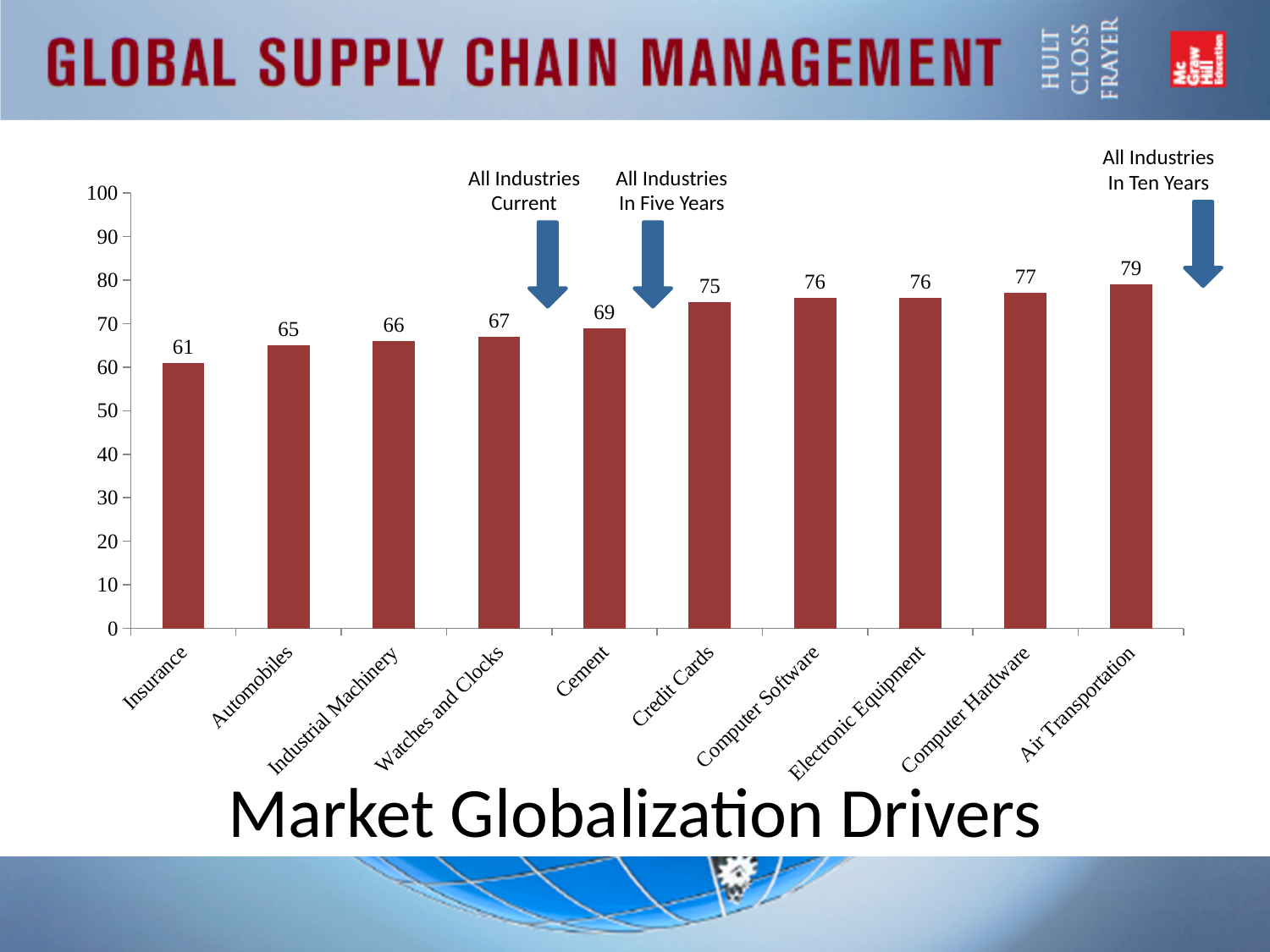
What is the difference between the values for Air Transportation and Insurance? 18 Is the value for Watches and Clocks greater or less than 70? less What kind of chart is shown on the slide? bar chart What is the title shown below the chart? Market Globalization Drivers Which category has the lowest value? Insurance Which category has the highest value? Air Transportation How many categories are shown on the x axis? 10 What is the value for Cement? 69 Which is larger, the value for Credit Cards or the value for Automobiles? Credit Cards Do the values generally rise or fall from left to right along the x axis? rise What is the value for Computer Hardware? 77 What is the value for Insurance? 61